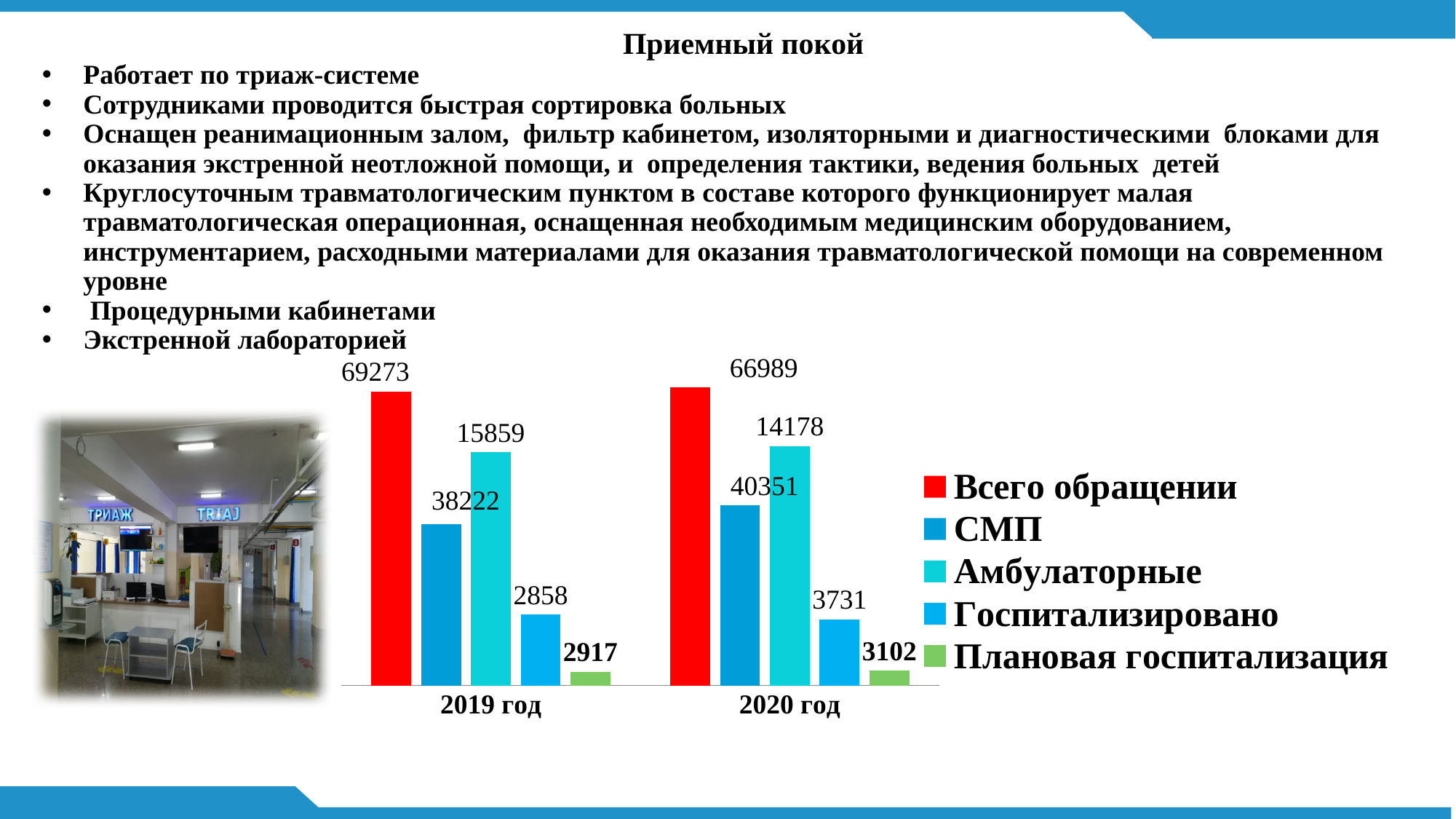
What kind of chart is shown on the slide? Bar chart What is the value for Госпитализировано in 2020 год? 3731 What is the value for СМП in 2020 год? 40351 What is the value for Всего обращении in 2019 год? 69273 How many categories are shown on the x axis? 2 Which series has the highest value in 2020 год? Всего обращении Which series has the lowest value in 2020 год? Плановая госпитализация What is the value for Плановая госпитализация in 2019 год? 2917 Which year has the larger value for СМП, 2019 год or 2020 год? 2020 год What is the difference between Всего обращении in 2019 год and 2020 год? 2284 What is the value for Амбулаторные in 2019 год? 15859 How many series does the legend list? 5